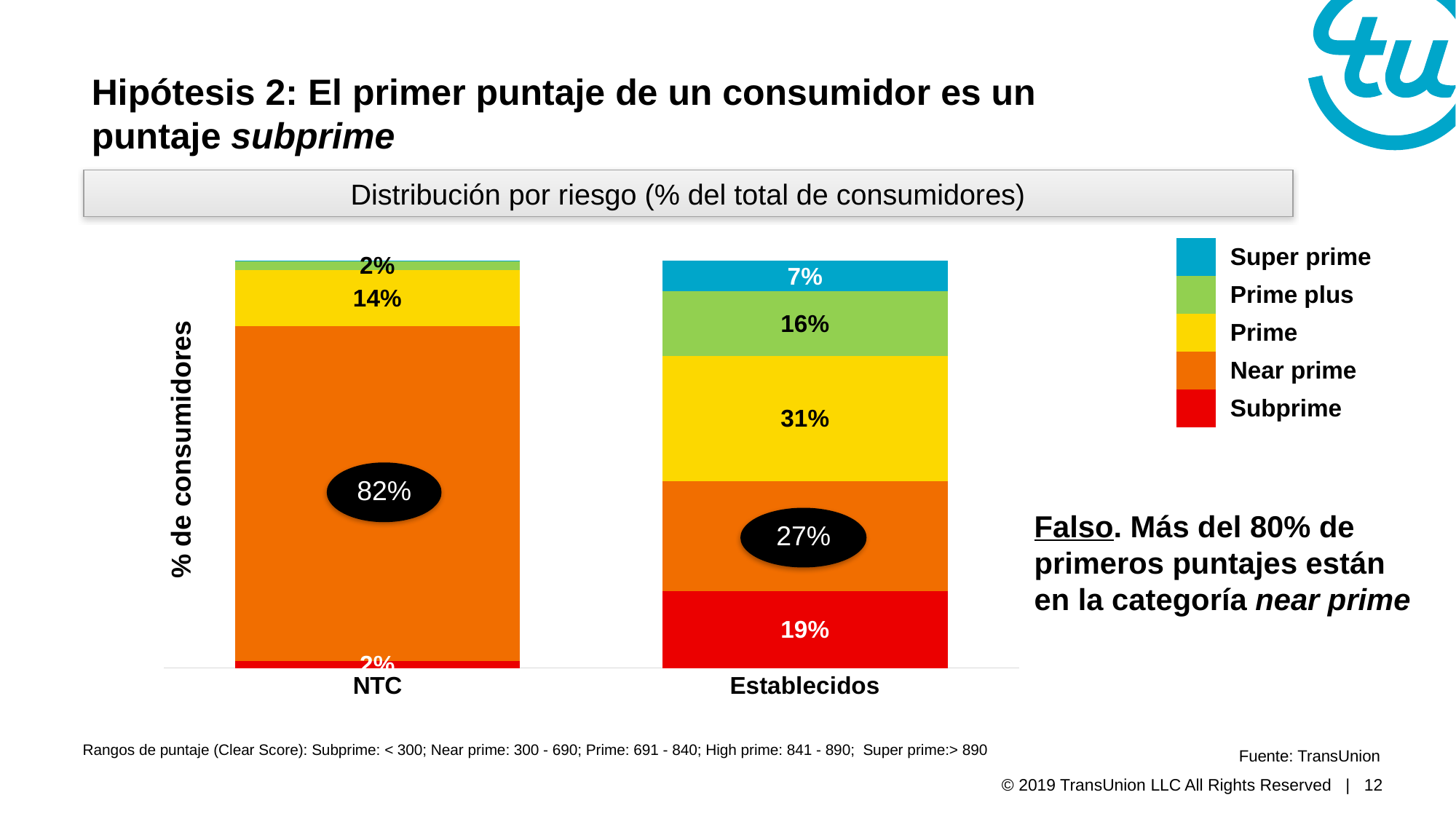
What type of chart is shown on the slide? Stacked bar chart What is the Subprime share for Establecidos? 19% What is the Prime share for Establecidos? 31% What percentage of Establecidos consumers fall in the Near prime category? 27% What is the Super prime share for Establecidos? 7% What is the Prime plus share for Establecidos? 16% What percentage of NTC consumers fall in the Near prime category? 82% How many risk categories does the legend list? 5 How many percentage points higher is the Near prime share for NTC than for Establecidos? 55 percentage points What is the Prime share for NTC? 14% Which group has a larger Near prime share, NTC or Establecidos? NTC Which risk category has the largest share in the Establecidos bar? Prime